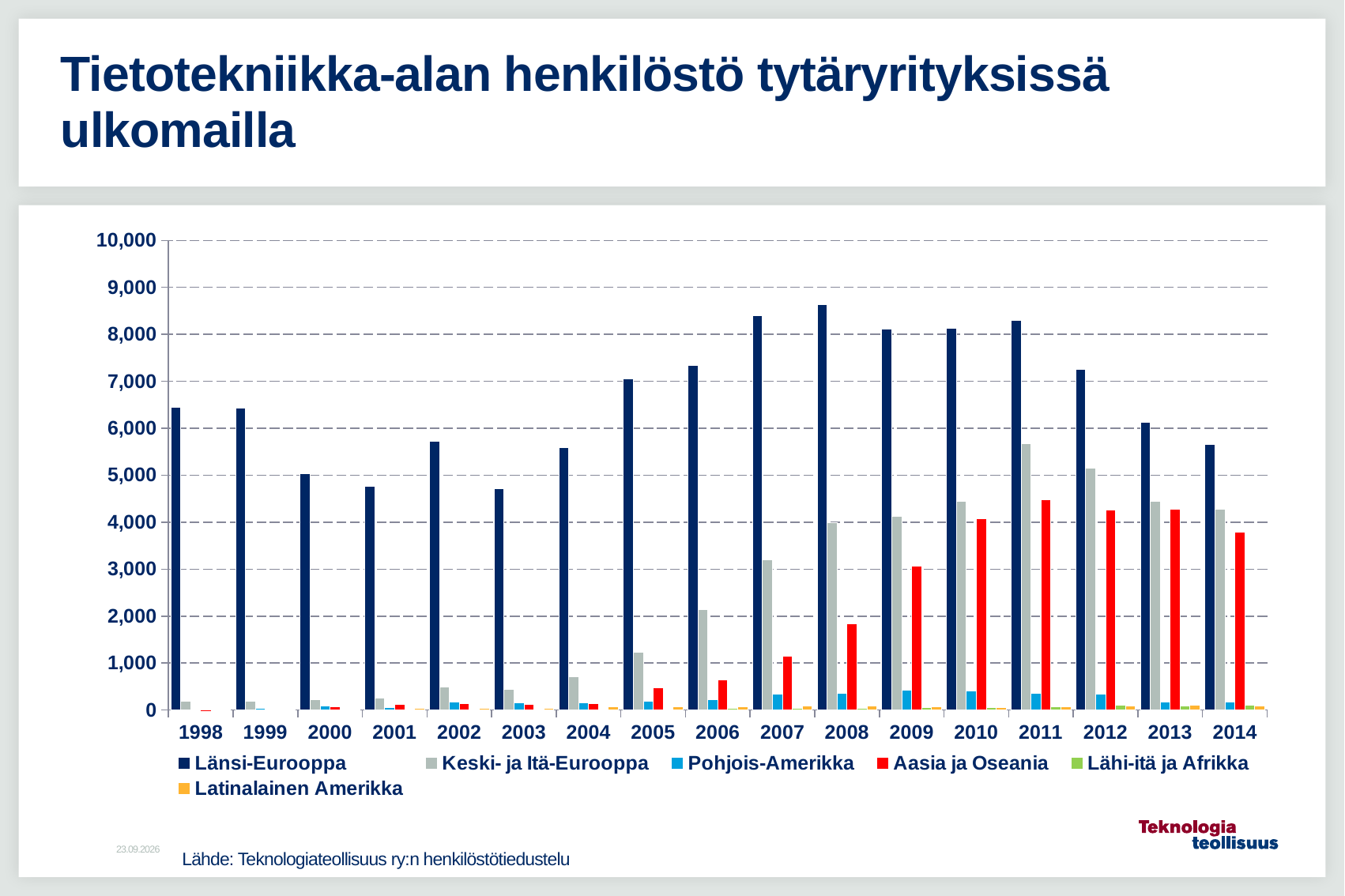
In 2014, which is larger: Keski- ja Itä-Eurooppa or Aasia ja Oseania? Keski- ja Itä-Eurooppa What kind of chart is shown on the slide? bar chart What is the title of the slide? Tietotekniikka-alan henkilöstö tytäryrityksissä ulkomailla In which year is the value for Länsi-Eurooppa highest? 2008 Is the value for Länsi-Eurooppa in 2000 greater or less than 6,000? less Is the value for Länsi-Eurooppa in 2008 greater or less than 8,000? greater How many years are shown on the x axis? 17 Does the value for Länsi-Eurooppa rise or fall from 2011 to 2014? fall Is the value for Aasia ja Oseania in 2010 greater or less than 3,000? greater Which is larger for Länsi-Eurooppa: 2004 or 2005? 2005 In which year is the value for Keski- ja Itä-Eurooppa highest? 2011 How many series does the legend list? 6